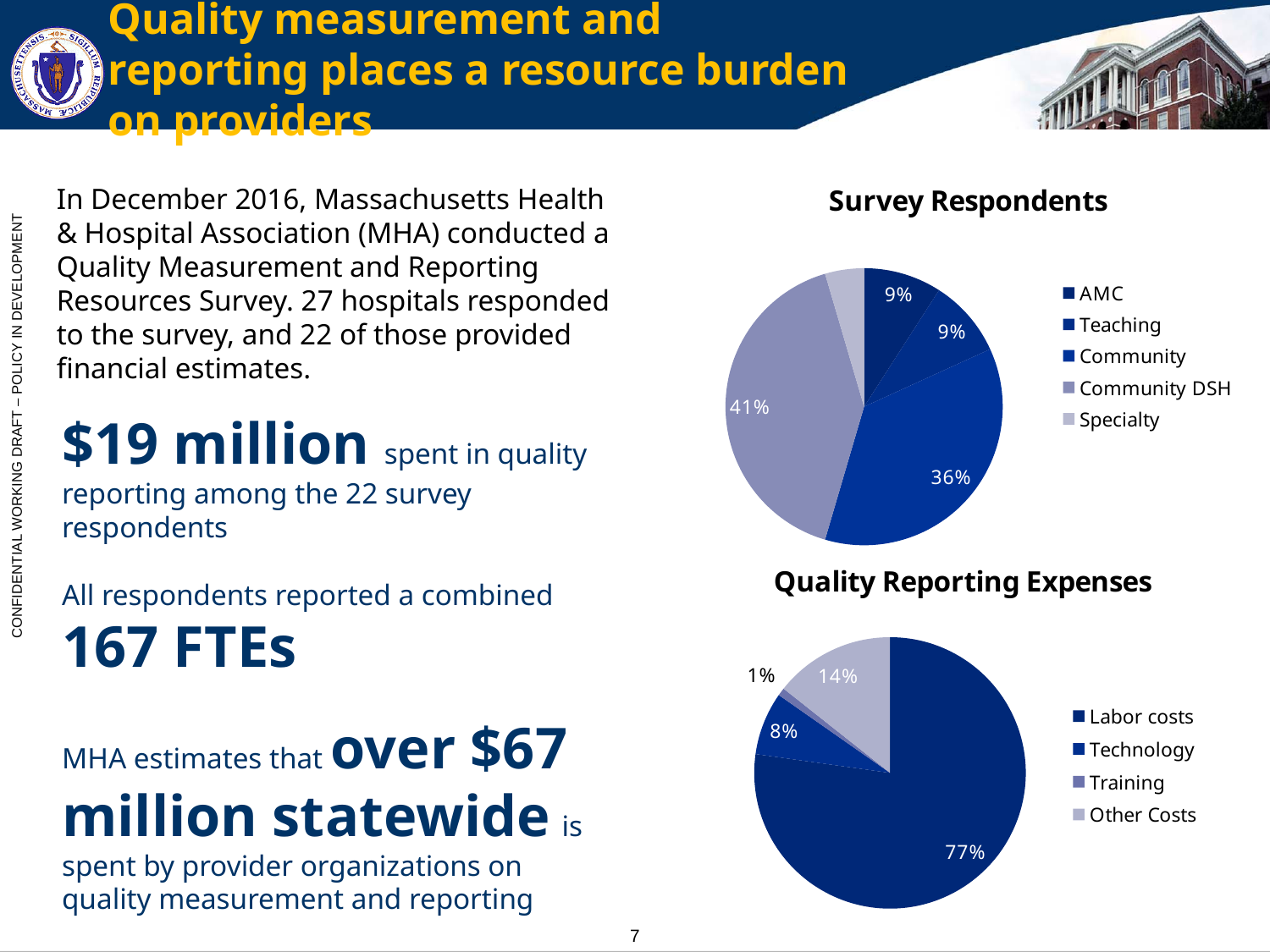
In the Survey Respondents chart, what share of respondents are AMC hospitals? 9% What kind of chart is the Quality Reporting Expenses chart? Pie chart In the Survey Respondents chart, what share of respondents are Community hospitals? 36% In the Quality Reporting Expenses chart, how many categories does the legend list? 4 In the Quality Reporting Expenses chart, what share is Labor costs? 77% In the Survey Respondents chart, what is the difference in percentage points between Community DSH and Community? 5 percentage points In the Quality Reporting Expenses chart, what share is Technology? 8% In the Survey Respondents chart, which category has the largest share? Community DSH In the Survey Respondents chart, how many categories does the legend list? 5 In the Quality Reporting Expenses chart, which is larger, Other Costs or Technology? Other Costs In the Quality Reporting Expenses chart, which category has the smallest share? Training In the Survey Respondents chart, what share of respondents are Community DSH hospitals? 41%